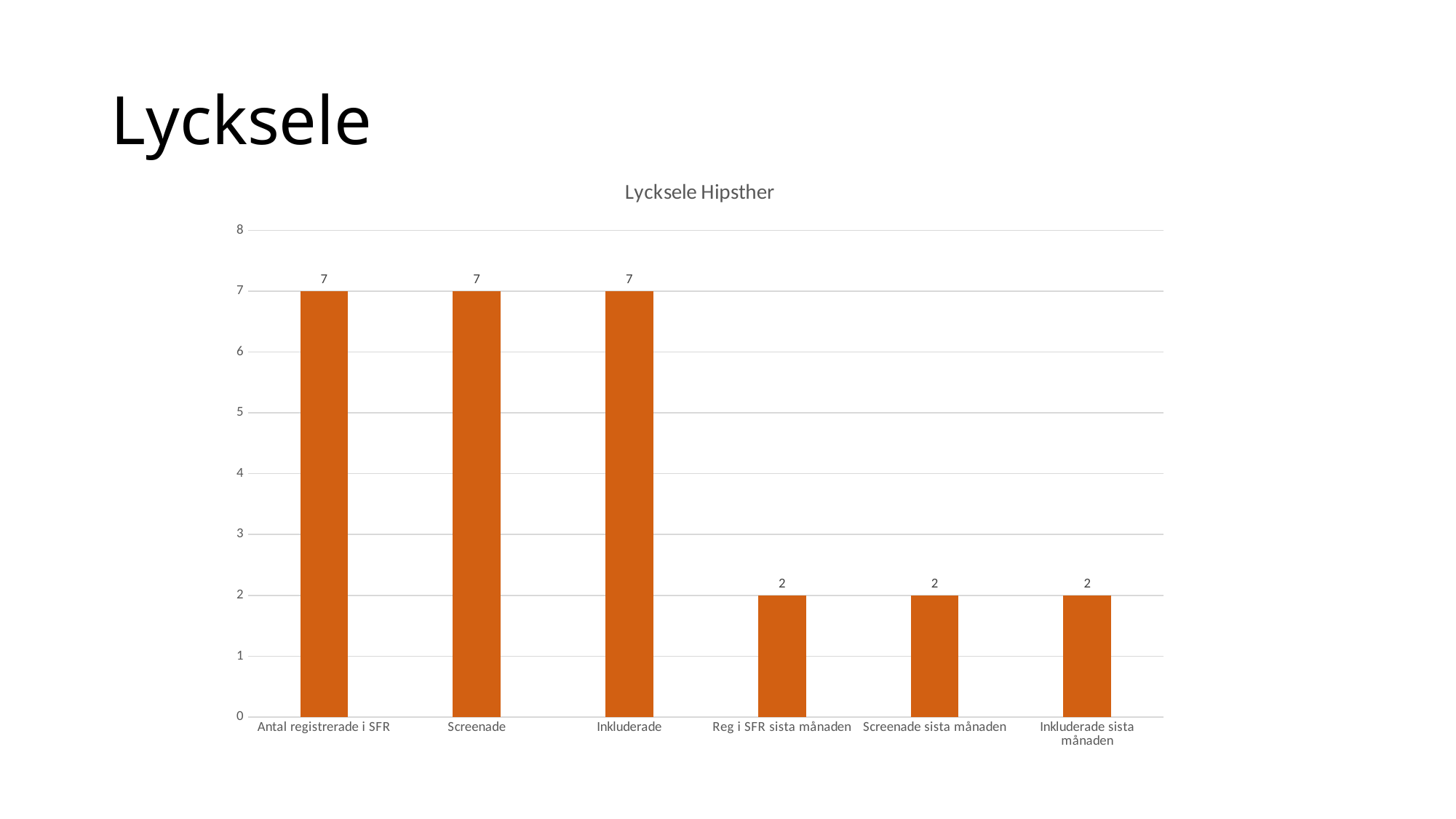
What is the value for Reg i SFR sista månaden? 2 Is the value for Screenade sista månaden greater or less than 4? less What is the difference between the values for Inkluderade and Inkluderade sista månaden? 5 What kind of chart is shown on the slide? bar chart What is the title of the chart? Lycksele Hipsther How many categories are shown on the x axis? 6 What is the value for Screenade? 7 What is the value for Inkluderade sista månaden? 2 What colour are the bars in the chart? orange Which is larger, the value for Screenade or the value for Screenade sista månaden? Screenade What is the value for Antal registrerade i SFR? 7 Is the value for Inkluderade greater or less than 5? greater